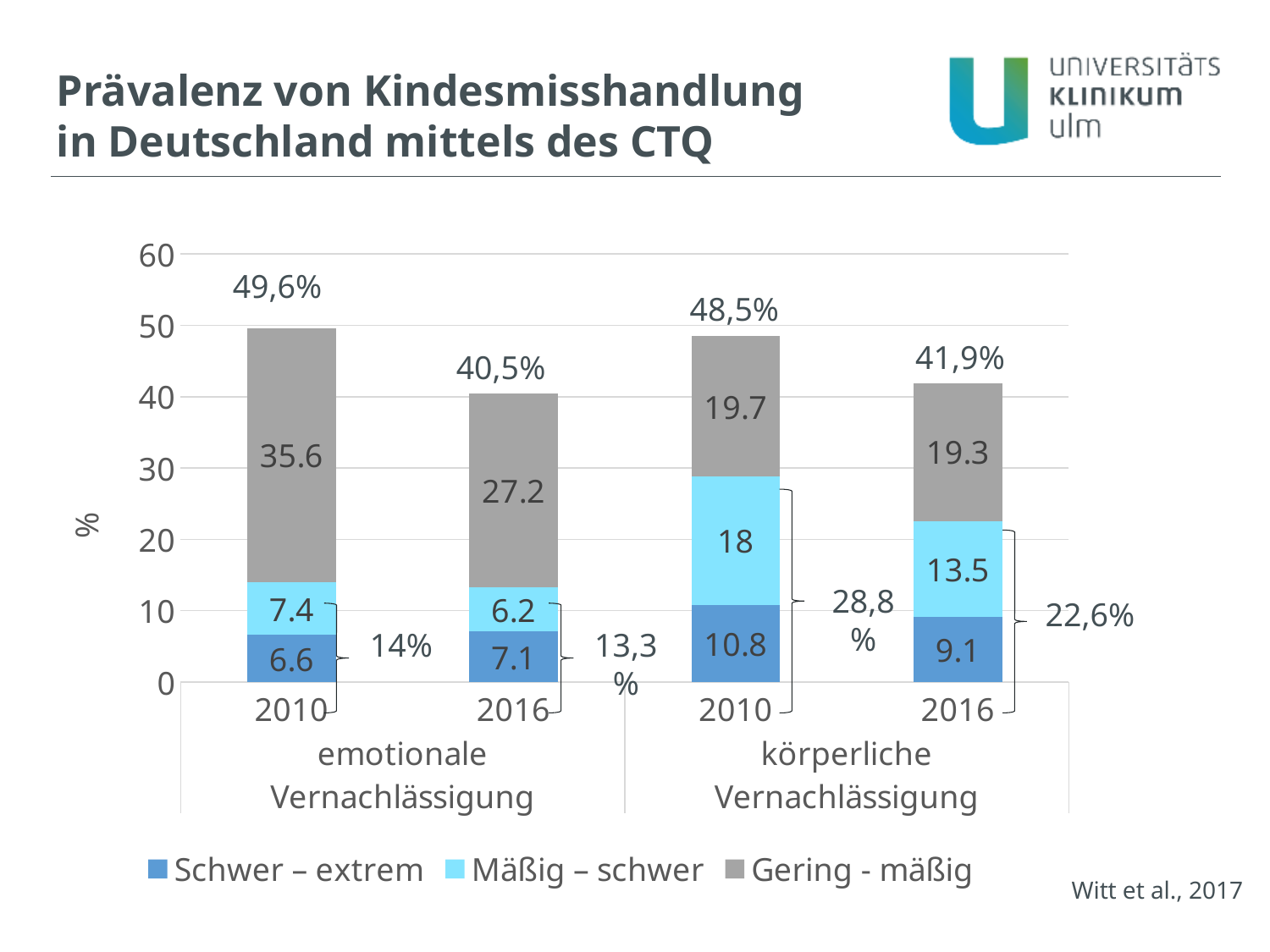
How many bars are plotted in the chart? 4 Which bar has the lowest total value? emotionale Vernachlässigung 2016 How many series does the legend list? 3 What is the total shown above the bar for emotionale Vernachlässigung in 2016? 40,5% What is the value of the 'Mäßig – schwer' segment for körperliche Vernachlässigung in 2016? 13.5 Is the 'Mäßig – schwer' value larger for körperliche Vernachlässigung in 2010 or in 2016? 2010 What is the value of the 'Schwer – extrem' segment for körperliche Vernachlässigung in 2010? 10.8 What kind of chart is shown on the slide? stacked bar chart What is the difference between the 'Gering - mäßig' values for emotionale Vernachlässigung in 2010 and 2016? 8.4 Which bar has the highest total value? emotionale Vernachlässigung 2010 What is the value of the 'Gering - mäßig' segment for emotionale Vernachlässigung in 2010? 35.6 What label is shown on the y axis? %